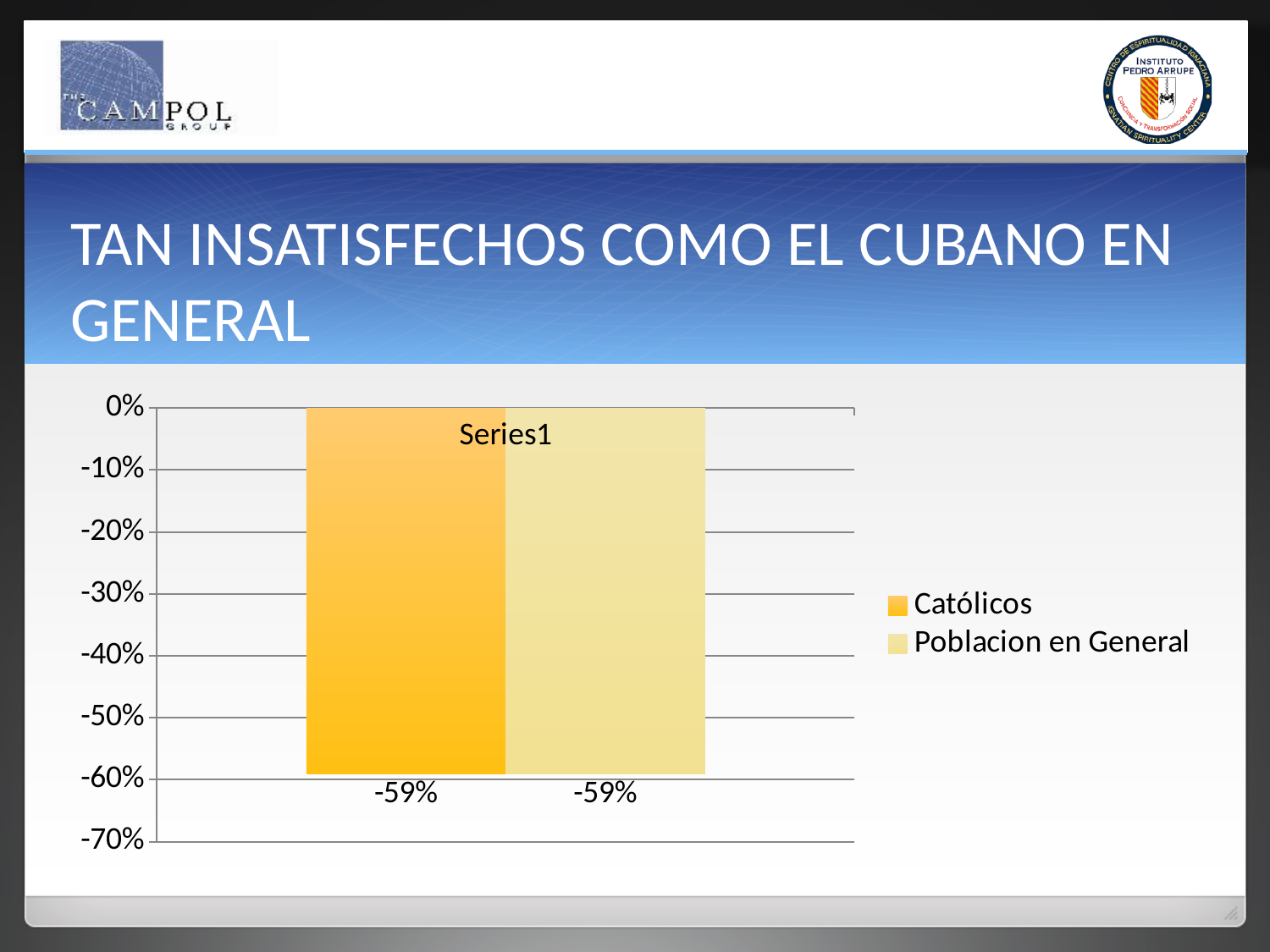
Is the value for Católicos greater or less than -50%? less How many series does the legend list? 2 What is the category label shown on the x axis of the chart? Series1 What is the lowest value shown on the y axis? -70% What kind of chart is shown on the slide? bar chart Which series is shown in the darker orange colour? Católicos How many bars are plotted in the chart? 2 What is the value for Católicos? -59% What is the difference between the values for Católicos and Poblacion en General? 0% Is the value for Poblacion en General greater or less than -60%? greater What is the value for Poblacion en General? -59%